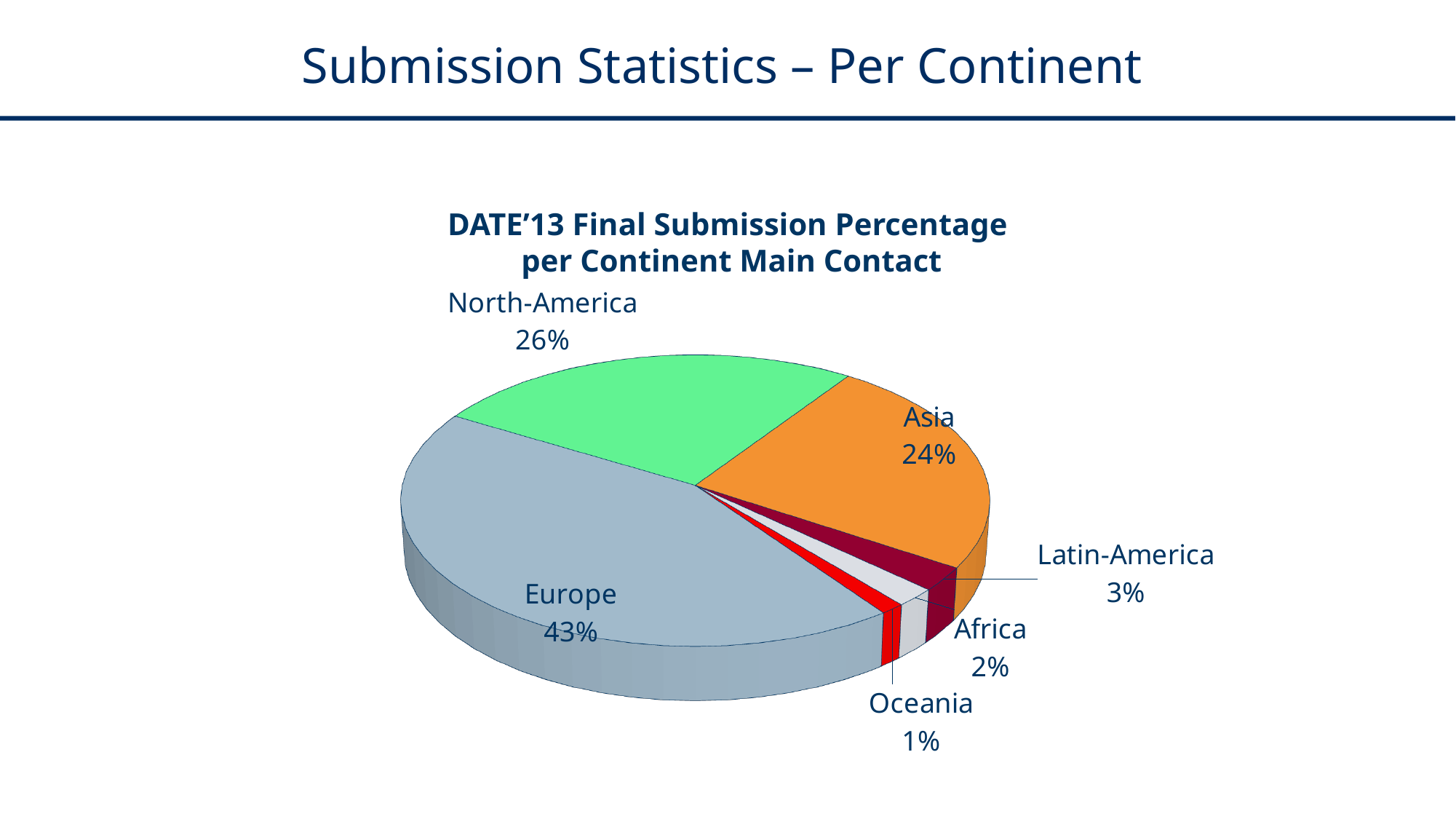
What percentage of submissions came from Asia? 24% What is the title of the chart? DATE'13 Final Submission Percentage per Continent Main Contact How many continents are shown in the pie chart? 6 Which has a larger share, North-America or Asia? North-America What colour is the Europe slice? Grey-blue What is the difference in percentage points between Europe and Asia? 19 What percentage of submissions came from Oceania? 1% What percentage of submissions came from Europe? 43% Which continent has the largest share of submissions? Europe Which continent has the smallest share of submissions? Oceania What type of chart is shown on the slide? Pie chart What percentage of submissions came from North-America? 26%